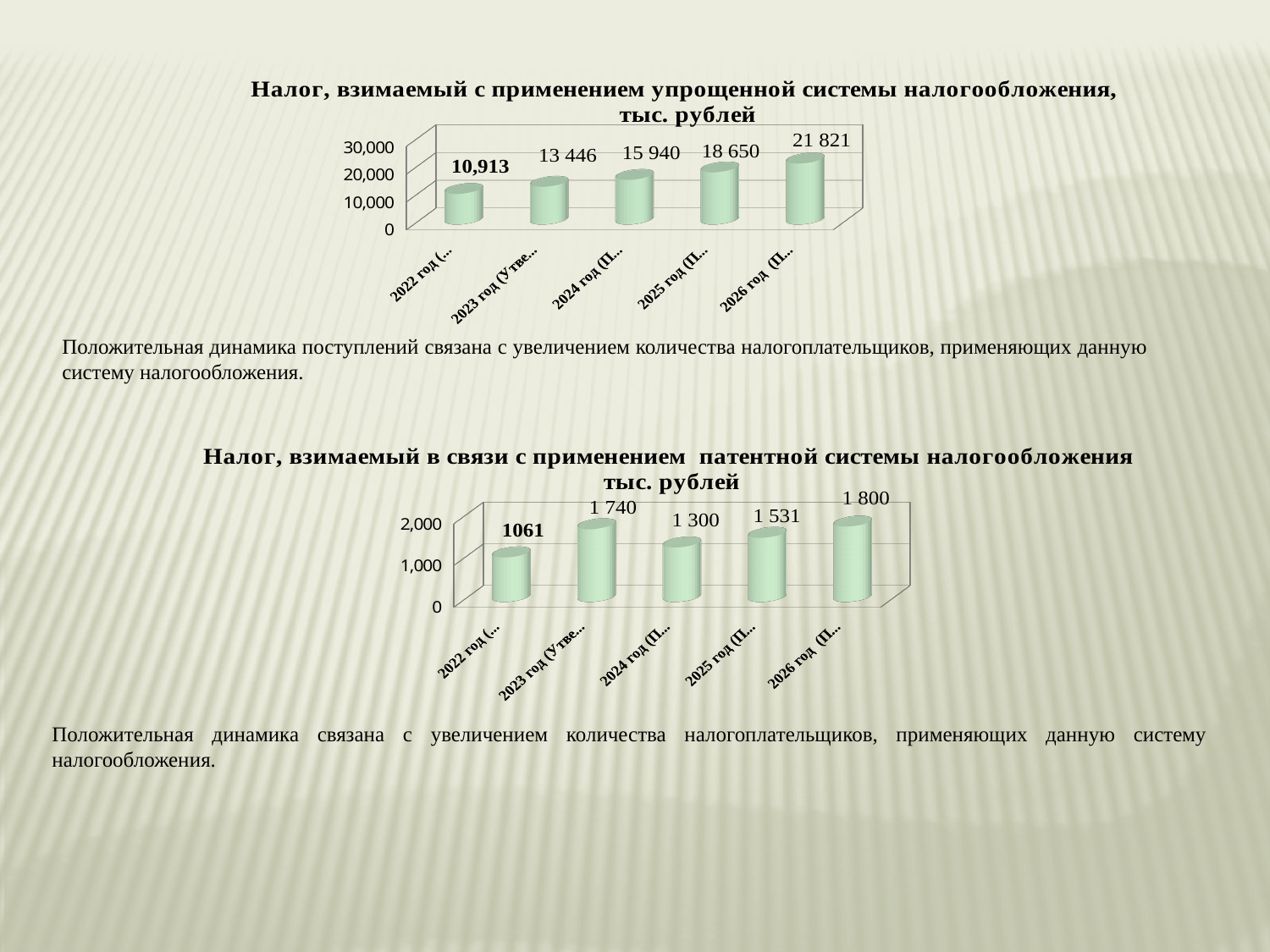
In the top chart (упрощенной системы налогообложения), do the values rise or fall from 2022 год to 2026 год? rise In the bottom chart (патентной системы налогообложения), what is the value for 2023 год? 1 740 In the top chart (упрощенной системы налогообложения), what is the value for 2022 год? 10,913 In the top chart (упрощенной системы налогообложения), what is the difference between the values for 2025 год and 2024 год? 2 710 In the bottom chart (патентной системы налогообложения), which is larger, the value for 2023 год or 2025 год? 2023 год In the top chart (упрощенной системы налогообложения), what is the value for 2026 год? 21 821 What kind of chart is the top chart (упрощенной системы налогообложения)? bar chart In the top chart (упрощенной системы налогообложения), which year has the lowest value? 2022 год In the bottom chart (патентной системы налогообложения), how many years are plotted? 5 In the bottom chart (патентной системы налогообложения), what is the value for 2024 год? 1 300 In the top chart (упрощенной системы налогообложения), which year has the highest value? 2026 год In the bottom chart (патентной системы налогообложения), which year has the highest value? 2026 год